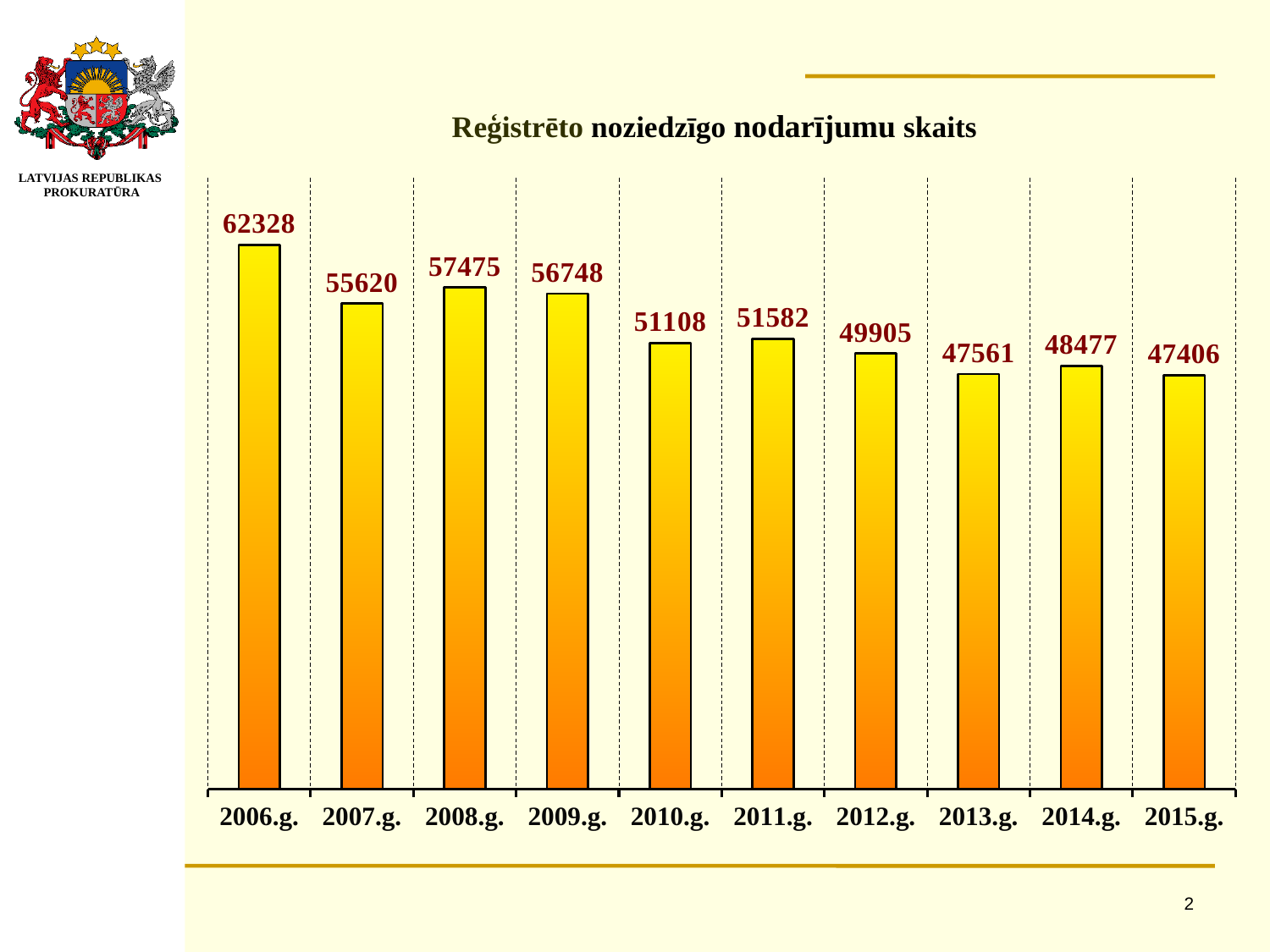
What kind of chart is this? bar chart How many years are shown on the x axis? 10 What is the value for 2006.g.? 62328 What is the difference between the values for 2008.g. and 2007.g.? 1855 Which is larger, the value for 2011.g. or the value for 2010.g.? 2011.g. What is the value for 2015.g.? 47406 What is the title of the chart? Reģistrēto noziedzīgo nodarījumu skaits Which year has the lowest value? 2015.g. Which year has the highest value? 2006.g. Do the values generally rise or fall from 2006.g. to 2015.g.? fall What is the difference between the values for 2006.g. and 2015.g.? 14922 What is the value for 2010.g.? 51108